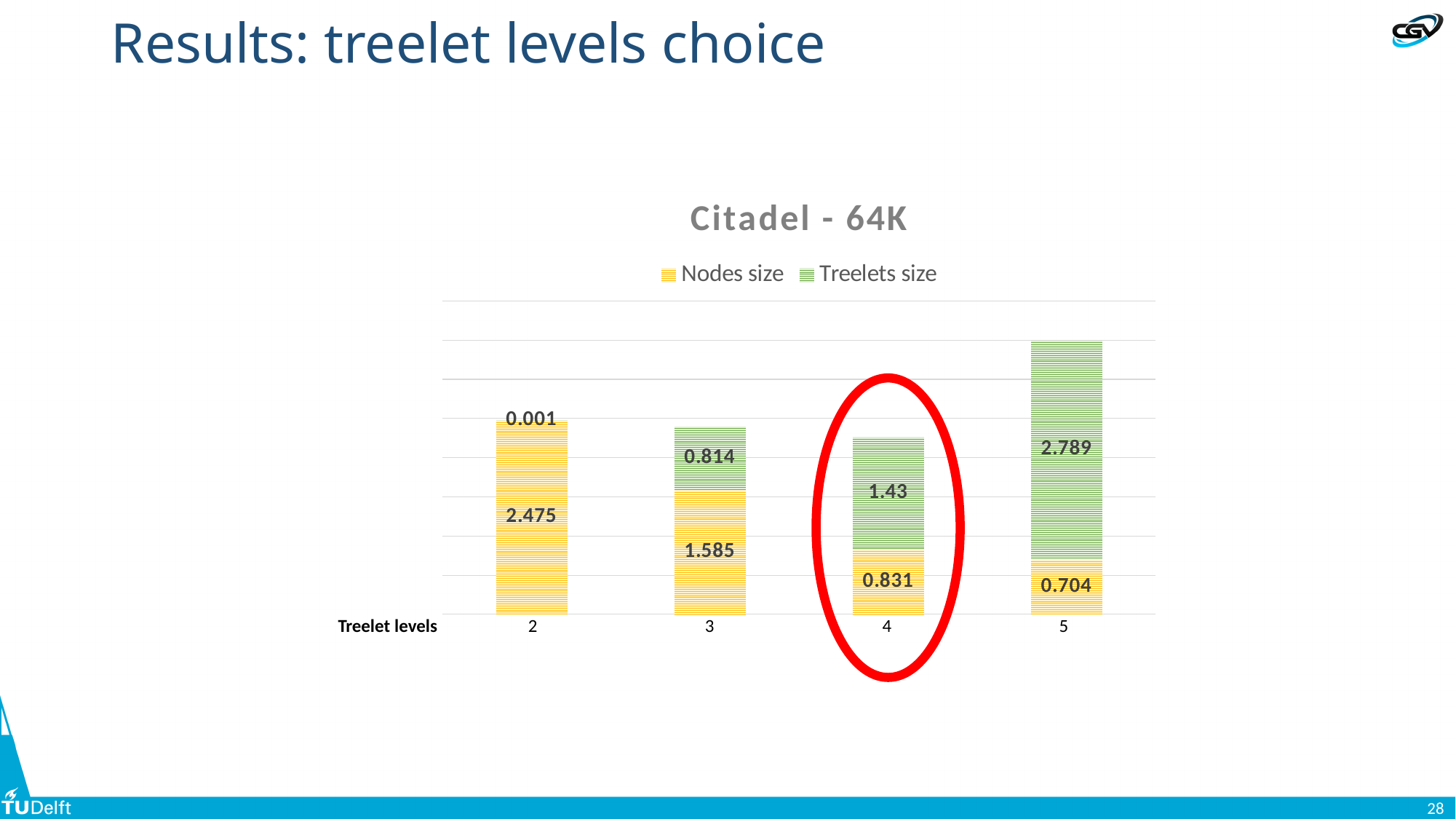
How many series does the legend list? 2 Which treelet level has the highest Treelets size? 5 What is the difference between the Nodes size at treelet level 3 and at treelet level 4? 0.754 What is the total height of the stacked bar for treelet level 4? 2.261 What kind of chart is shown on the slide? stacked bar chart What is the Nodes size value for treelet level 2? 2.475 What is the Treelets size value for treelet level 3? 0.814 Which treelet level has the lowest Nodes size? 5 Is the Nodes size larger at treelet level 2 or at treelet level 3? treelet level 2 What is the Nodes size value for treelet level 5? 0.704 What is the Treelets size value for treelet level 4? 1.43 How many treelet levels are shown on the x axis? 4